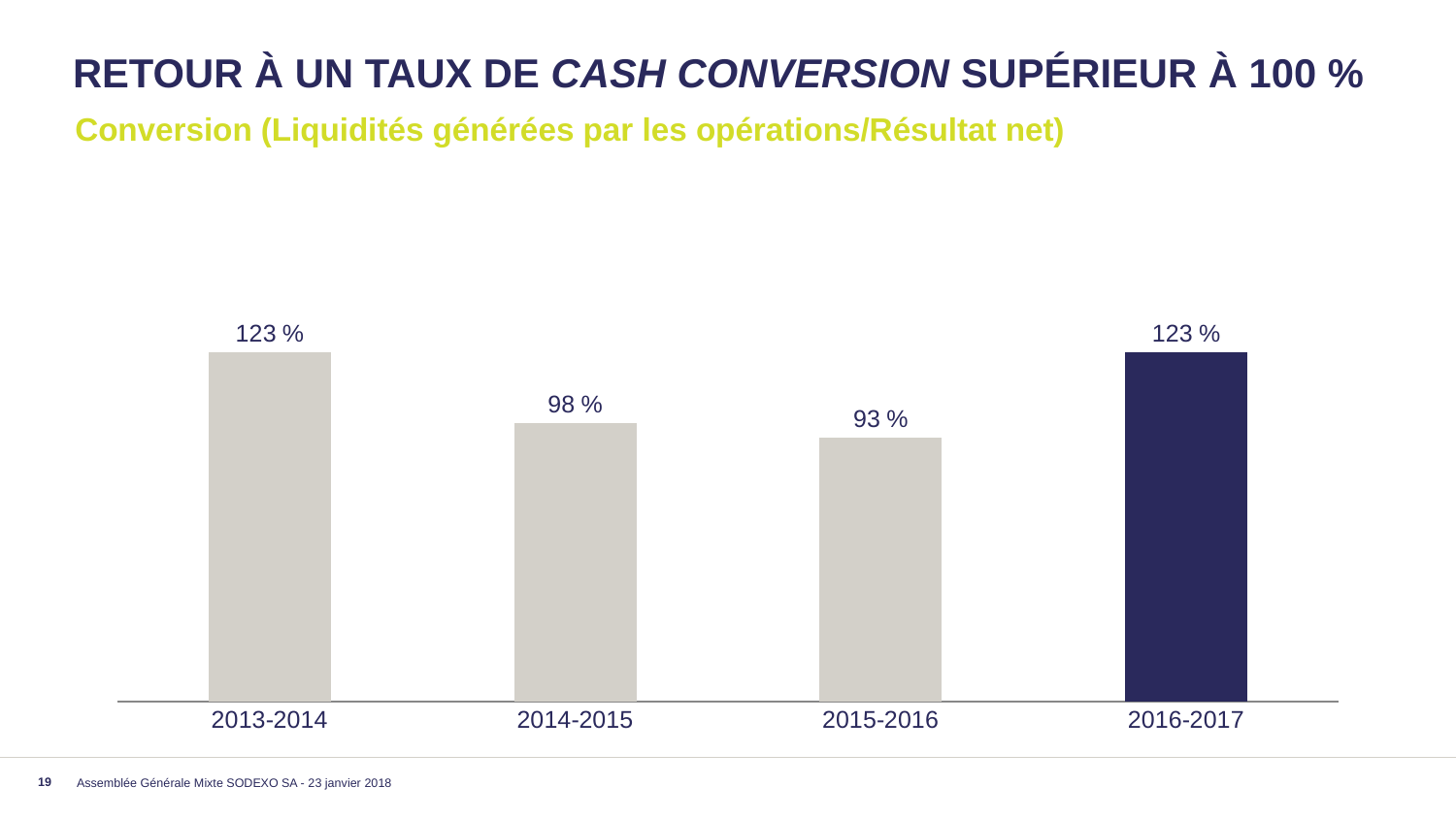
Did the cash conversion rate rise or fall from 2015-2016 to 2016-2017? Rise What is the difference in cash conversion rate between 2013-2014 and 2014-2015? 25 % What type of chart is shown on the slide? Bar chart Which bar is shown in a different colour (dark blue) from the others? 2016-2017 What is the cash conversion rate for 2016-2017? 123 % What is the difference in cash conversion rate between 2016-2017 and 2015-2016? 30 % What is the cash conversion rate for 2015-2016? 93 % What is the cash conversion rate for 2014-2015? 98 % How many periods are shown in the chart? 4 Which period has a higher cash conversion rate, 2014-2015 or 2015-2016? 2014-2015 What is the cash conversion rate for 2013-2014? 123 % Which period has the lowest cash conversion rate? 2015-2016